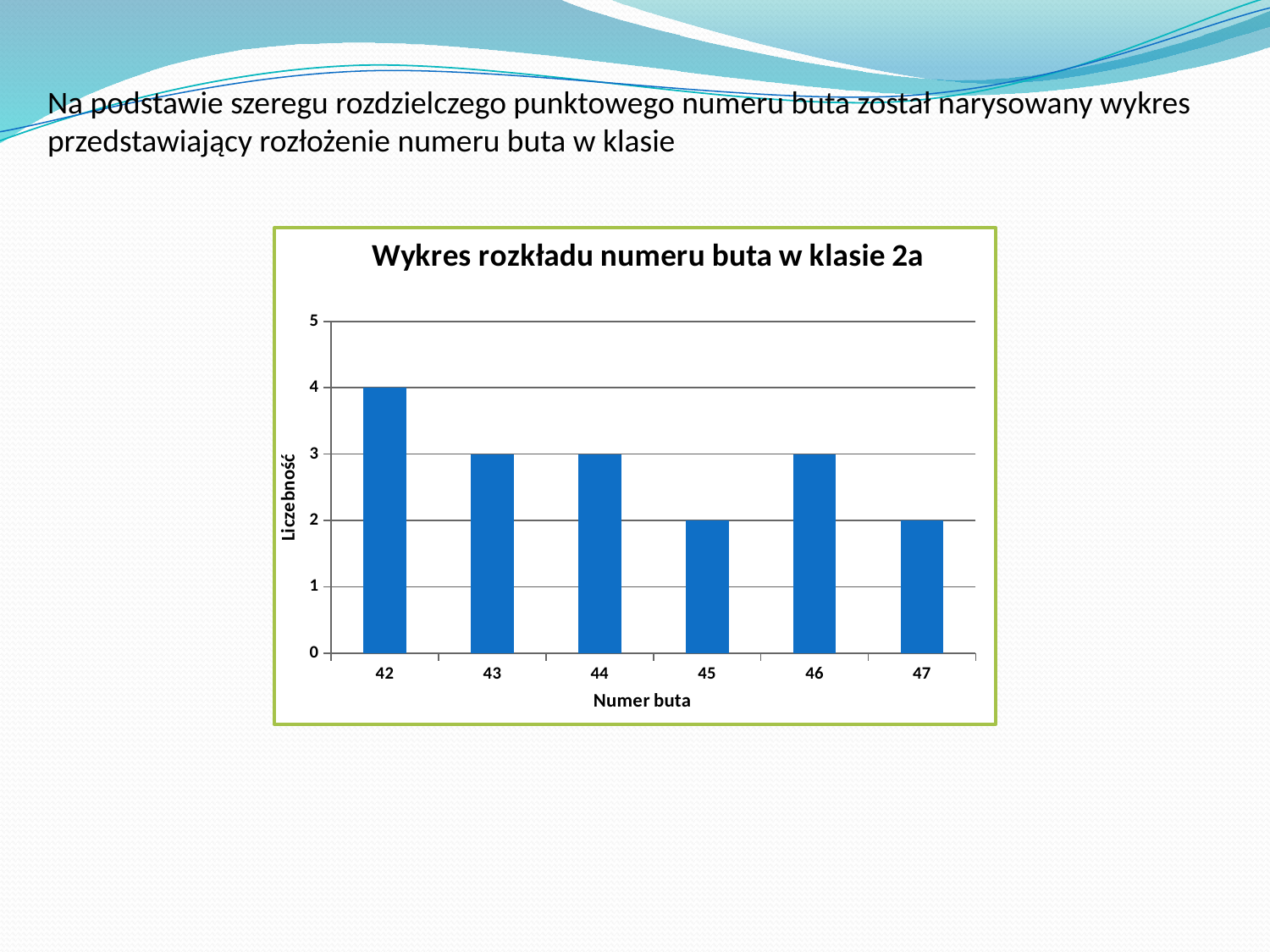
What is the count for shoe size 46? 3 What is the difference between the count for shoe size 42 and the count for shoe size 45? 2 How many shoe sizes are shown on the x axis? 6 Which has a larger count, shoe size 42 or shoe size 43? 42 Is the value for shoe size 42 greater or less than 3? greater What kind of chart is shown on the slide? bar chart What is the count for shoe size 47? 2 Which shoe size has the highest count? 42 What is the count for shoe size 45? 2 What is the count (Liczebność) for shoe size 42? 4 What is the title of the chart? Wykres rozkładu numeru buta w klasie 2a What is the label of the x axis? Numer buta